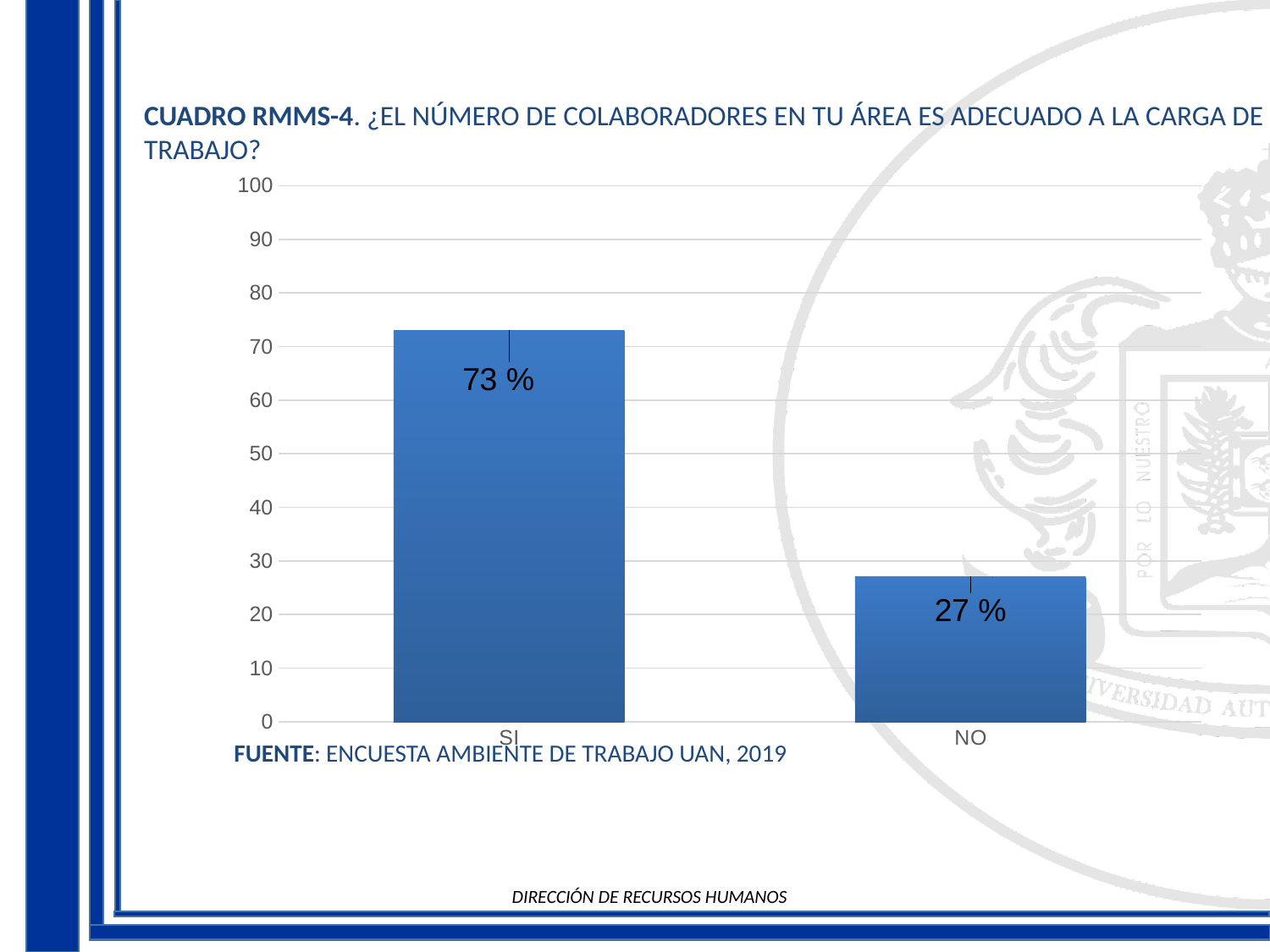
What is the maximum value shown on the y axis? 100 What is the value for SI? 73 % What is the difference between the values for SI and NO? 46 % Is the value for SI greater or less than 70? greater Which category has the highest value? SI Is the value for NO greater or less than 30? less What kind of chart is shown on the slide? bar chart What source is cited below the chart? ENCUESTA AMBIENTE DE TRABAJO UAN, 2019 How many categories are shown on the x axis? 2 Which category has the lowest value? NO What is the value for NO? 27 % Which is larger, the value for SI or the value for NO? SI